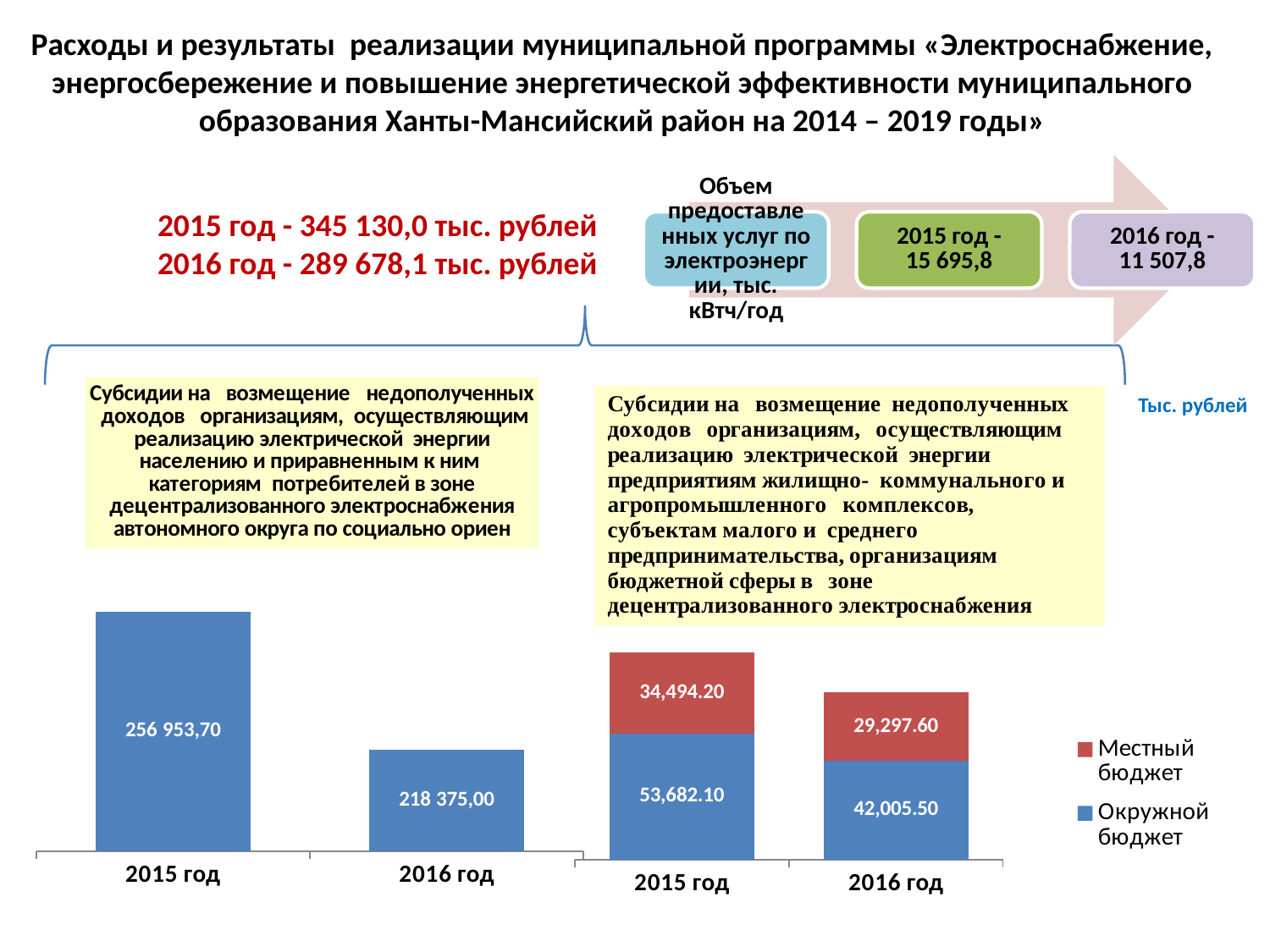
In the left chart, what is the value for 2016 год? 218 375,00 In the right chart, which is larger for 2016 год: Местный бюджет or Окружной бюджет? Окружной бюджет In the left chart, what is the value for 2015 год? 256 953,70 In the right chart, what is the total of the stacked bar for 2015 год? 88,176.30 In the right chart, what is the Местный бюджет value for 2015 год? 34,494.20 In the left chart, what is the difference between the 2015 год and 2016 год values? 38 578,70 In the right chart, how many series does the legend list? 2 In the left chart, how many bars are plotted? 2 In the right chart, what is the Окружной бюджет value for 2016 год? 42,005.50 What kind of chart is the right chart? Stacked bar chart In the right chart, what is the total of the stacked bar for 2016 год? 71,303.10 In the left chart, which year has the higher value? 2015 год